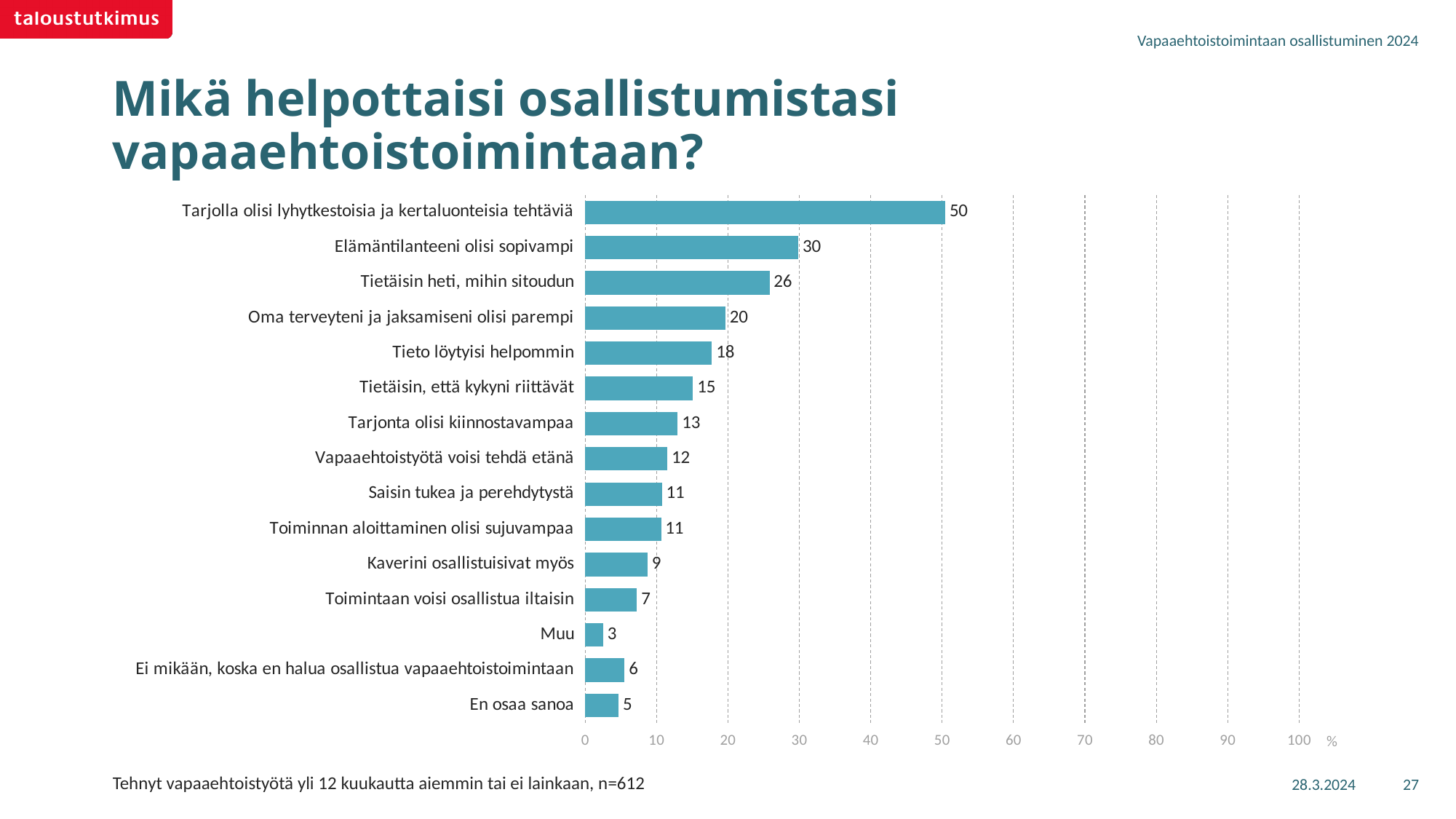
Which category has the highest value? Tarjolla olisi lyhytkestoisia ja kertaluonteisia tehtäviä What unit is shown at the end of the x axis? % What is the value for "Tarjolla olisi lyhytkestoisia ja kertaluonteisia tehtäviä"? 50 Which category has the lowest value? Muu How many categories are shown in the chart? 15 What is the value for "Tieto löytyisi helpommin"? 18 Is the value for "Oma terveyteni ja jaksamiseni olisi parempi" greater or less than 30? less What is the value for "En osaa sanoa"? 5 What is the value for "Muu"? 3 What is the difference between "Elämäntilanteeni olisi sopivampi" and "Tietäisin heti, mihin sitoudun"? 4 What kind of chart is shown on the slide? bar chart Which is larger: "Kaverini osallistuisivat myös" or "Toimintaan voisi osallistua iltaisin"? Kaverini osallistuisivat myös